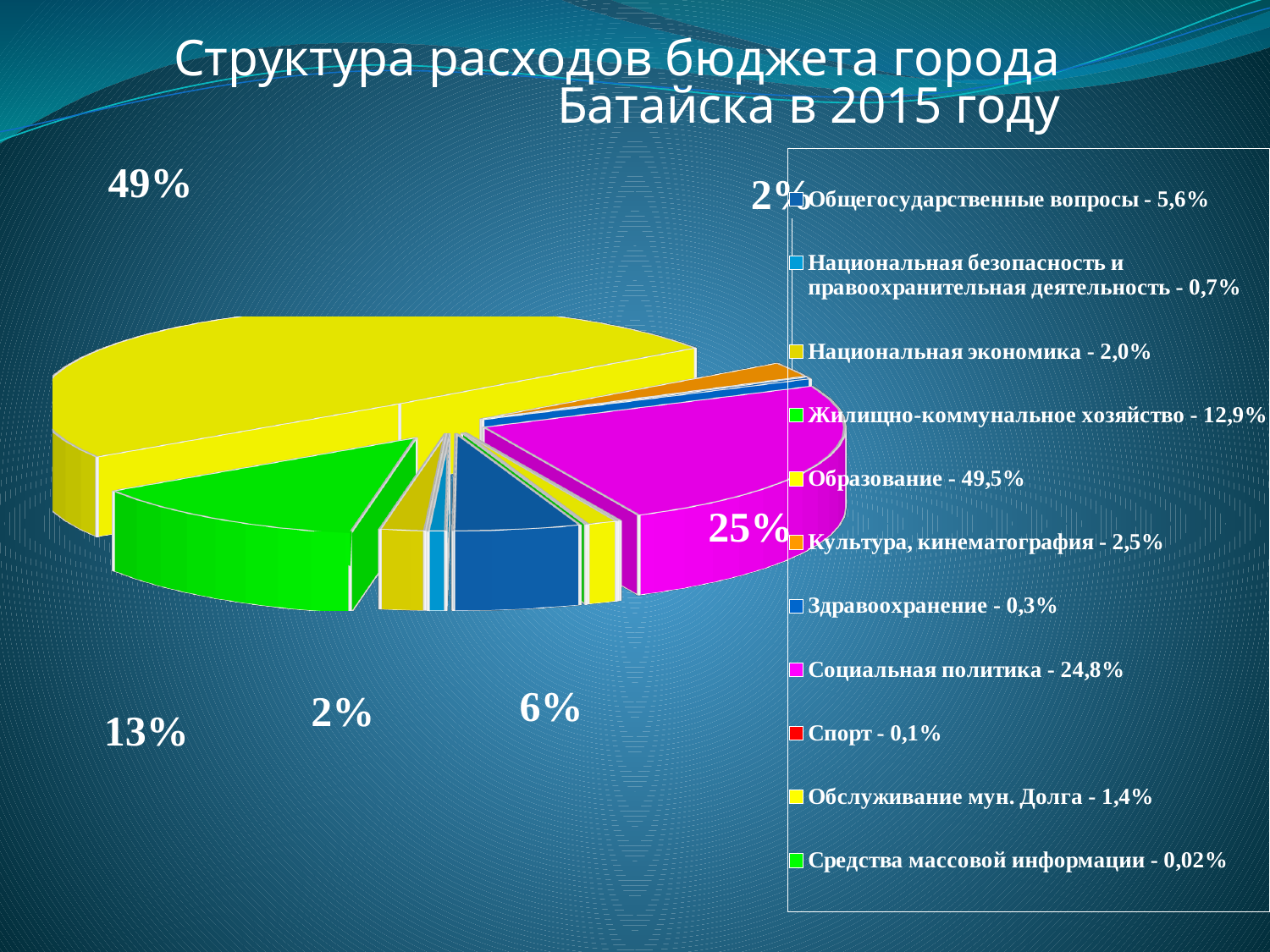
What data label is printed on the largest slice of the pie? 49% Which category has the largest share of the budget expenditures? Образование What kind of chart is shown on the slide? pie chart What share of expenditures does the legend give for Жилищно-коммунальное хозяйство? 12,9% How many categories does the legend of the pie chart list? 11 What share of expenditures does the legend give for Социальная политика? 24,8% Which category has the smallest share of the budget expenditures? Средства массовой информации What is the title of the chart on the slide? Структура расходов бюджета города Батайска в 2015 году What share of expenditures does the legend give for Общегосударственные вопросы? 5,6% What is the difference between the shares for Образование and Социальная политика, according to the legend? 24,7% What share of expenditures does the legend give for Культура, кинематография? 2,5% Which is larger: the share for Социальная политика or the share for Жилищно-коммунальное хозяйство? Социальная политика